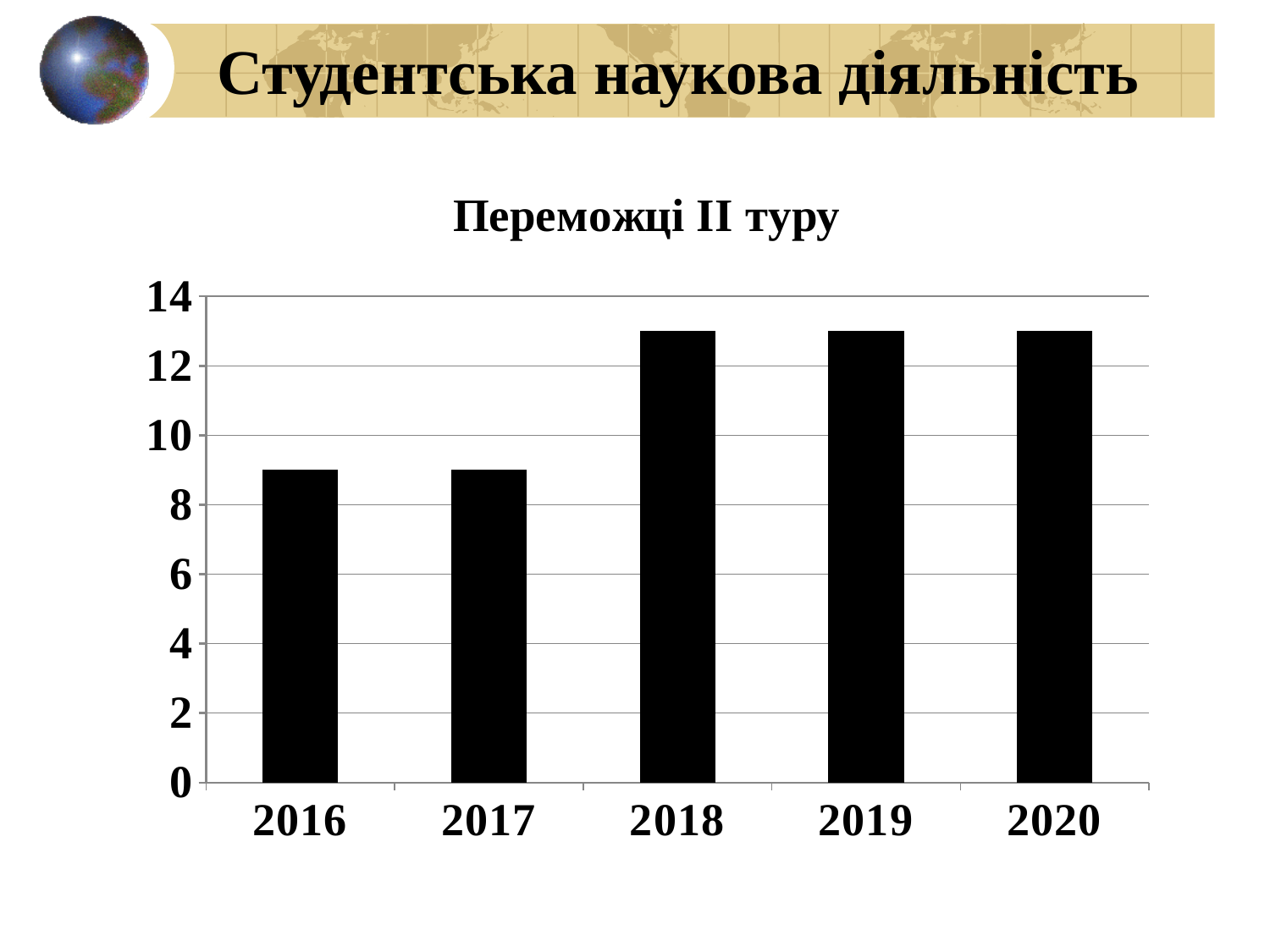
Is the value for 2016 greater or less than 10? less Which year has the larger value, 2017 or 2019? 2019 Is the value for 2016 greater or less than 8? greater Is the value for 2018 greater or less than 12? greater Do the values rise or fall from 2016 to 2020? rise Which year has the larger value, 2016 or 2018? 2018 How many years are shown on the x axis of the chart? 5 What kind of chart is shown on the slide? bar chart What is the first year shown on the x axis? 2016 What is the title of the chart? Переможці ІІ туру